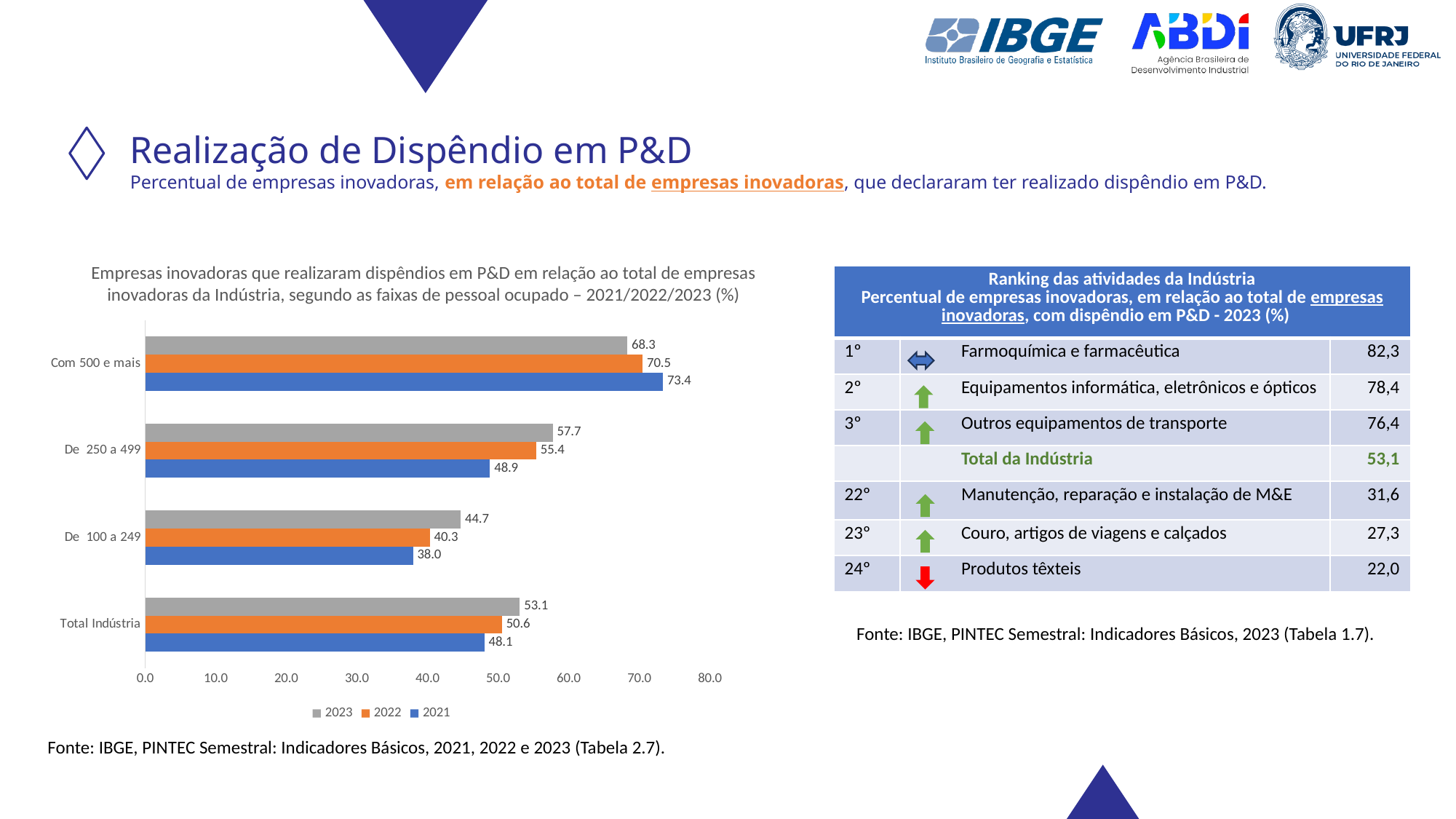
Which colour represents the 2022 series in the chart? Orange What is the difference between the 2023 and 2021 values for "De 250 a 499"? 8.8 What is the 2023 value for "De 100 a 249"? 44.7 What is the 2022 value for "Total Indústria"? 50.6 Which category has the lowest 2021 value? De 100 a 249 How many categories are shown on the chart? 4 What kind of chart is shown on the slide? Bar chart What is the 2021 value for "Com 500 e mais"? 73.4 Which category has the highest 2023 value? Com 500 e mais How many series does the chart legend list? 3 Is the 2022 value for "De 100 a 249" greater or less than 50.0? less For "Com 500 e mais", which is larger: the 2021 value or the 2023 value? 2021